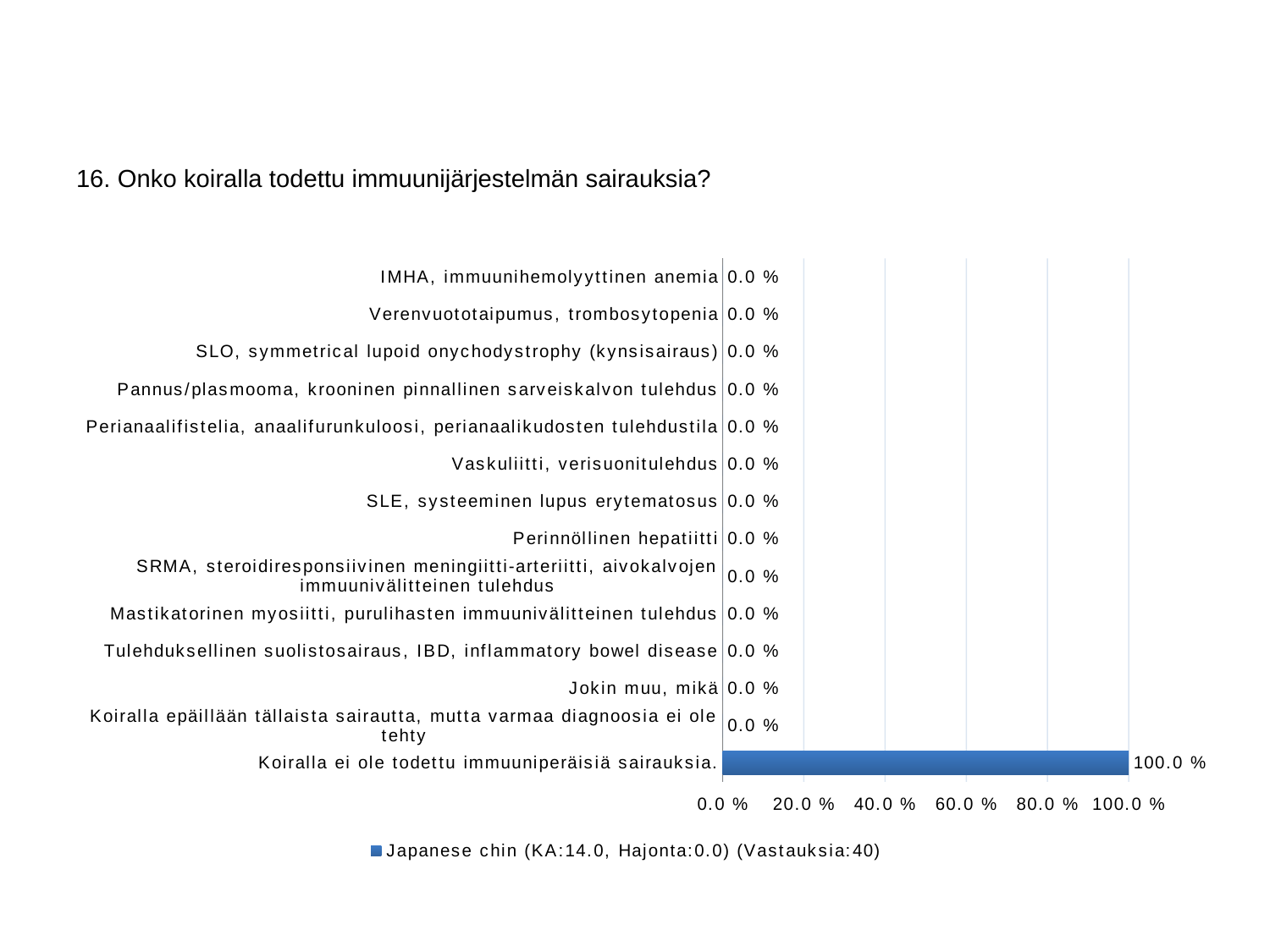
What is the value for "Koiralla ei ole todettu immuuniperäisiä sairauksia."? 100.0 % Is the value for "Koiralla ei ole todettu immuuniperäisiä sairauksia." greater or less than 80.0 %? greater What is the value for "Jokin muu, mikä"? 0.0 % How many categories are shown on the chart? 14 What is the value for "SLE, systeeminen lupus erytematosus"? 0.0 % What kind of chart is shown on the slide? bar chart Which is larger: the value for "Koiralla ei ole todettu immuuniperäisiä sairauksia." or the value for "Perinnöllinen hepatiitti"? Koiralla ei ole todettu immuuniperäisiä sairauksia. What is the difference between the value for "Koiralla ei ole todettu immuuniperäisiä sairauksia." and the value for "Vaskuliitti, verisuonitulehdus"? 100.0 % Which category has the highest value? Koiralla ei ole todettu immuuniperäisiä sairauksia. What is the value for "IMHA, immuunihemolyyttinen anemia"? 0.0 % How many series does the legend list? 1 What is the legend entry for the series shown? Japanese chin (KA:14.0, Hajonta:0.0) (Vastauksia:40)